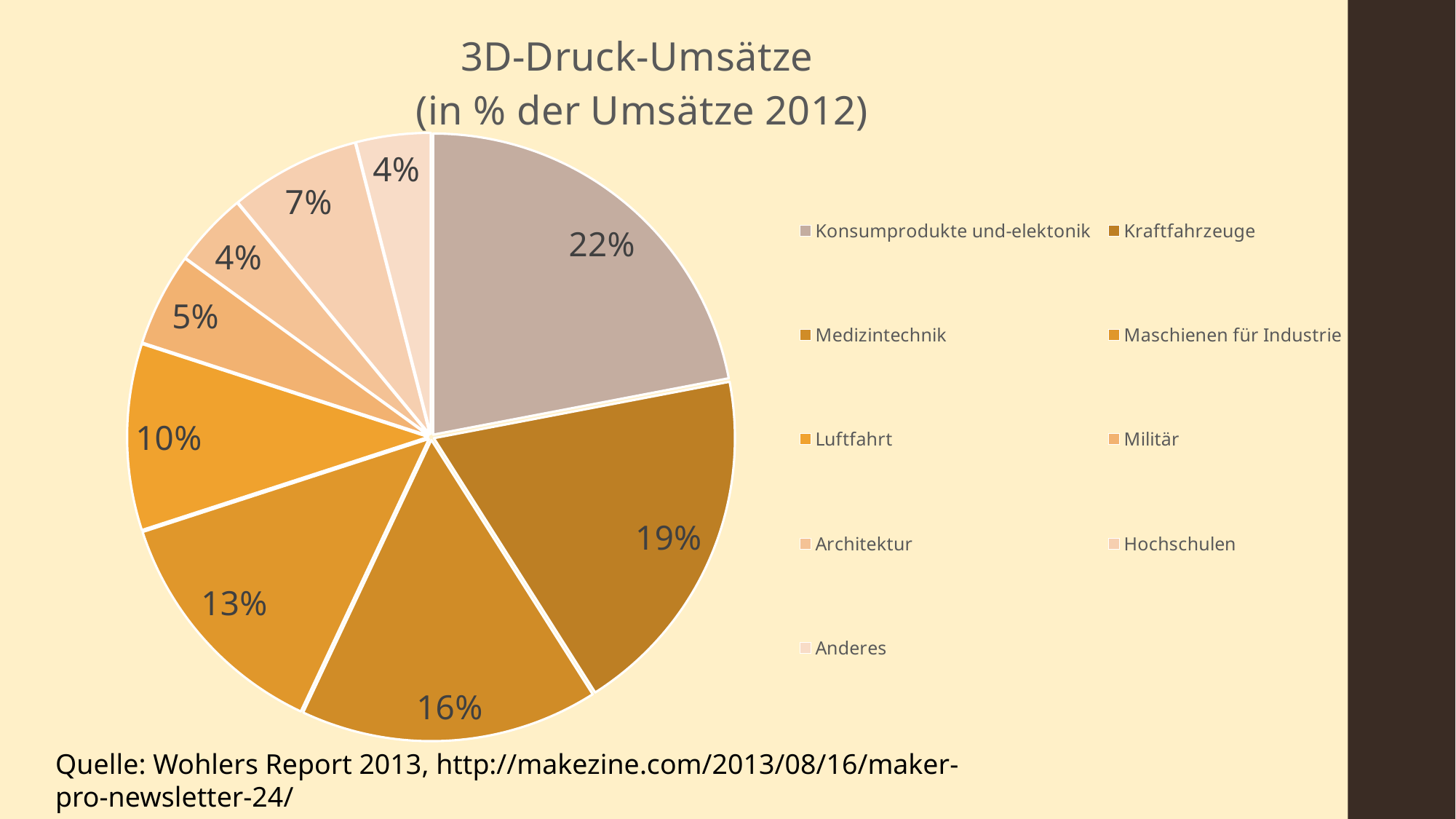
What percentage is shown for Medizintechnik? 16% What percentage is shown for Luftfahrt? 10% What kind of chart is shown on the slide? pie chart What is the difference in percentage points between Kraftfahrzeuge and Maschienen für Industrie? 6 Which is larger, the slice for Militär or the slice for Hochschulen? Hochschulen What percentage is shown for Kraftfahrzeuge? 19% Which category has the largest slice of the pie? Konsumprodukte und -elektonik What share of 3D-Druck-Umsätze does Konsumprodukte und -elektonik account for? 22% What is the title of the chart? 3D-Druck-Umsätze (in % der Umsätze 2012) How many slices does the pie chart have? 9 How many entries does the legend list? 9 What percentage is shown for Hochschulen? 7%